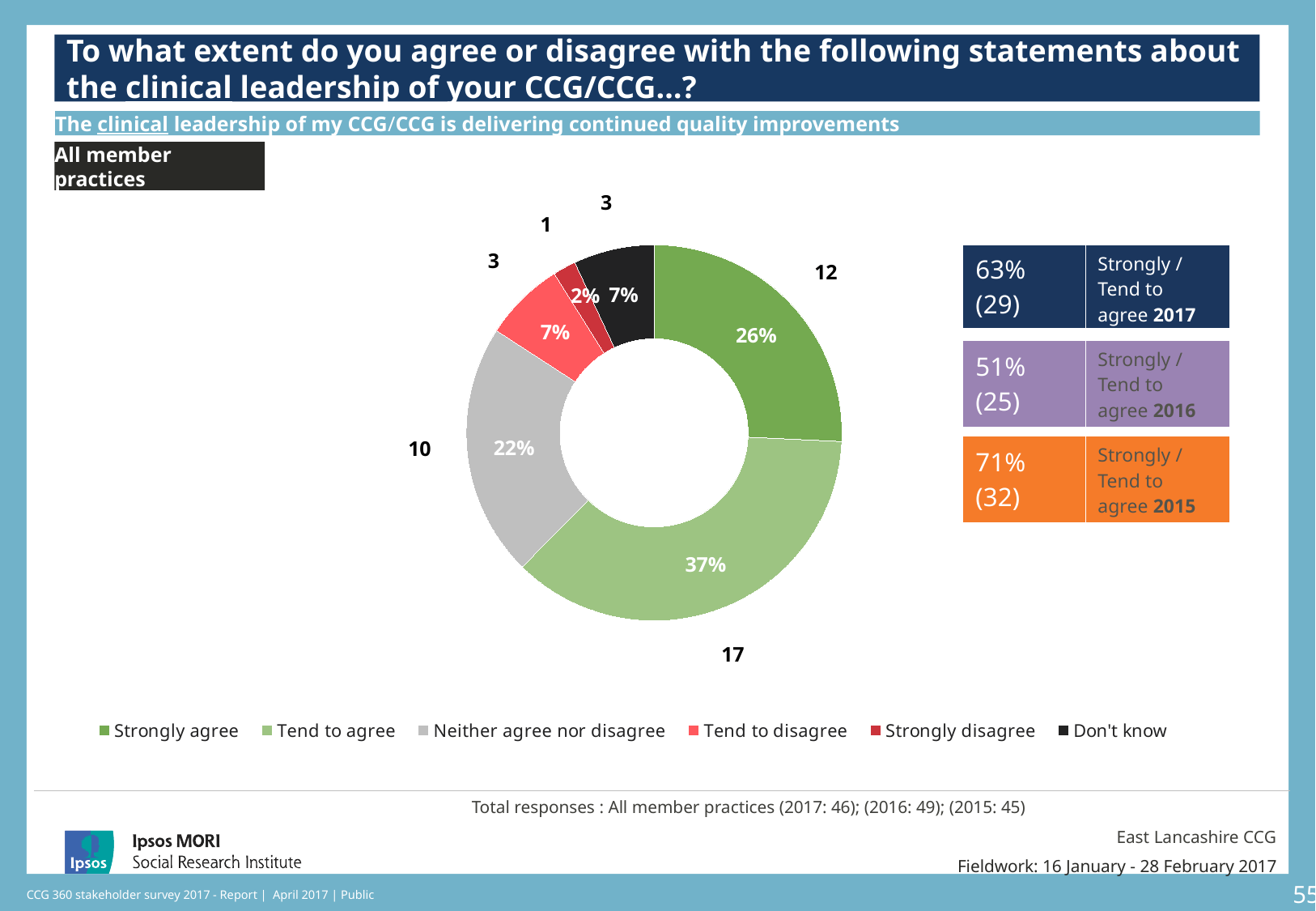
Which is larger: the share for 'Neither agree nor disagree' or the share for 'Tend to disagree'? Neither agree nor disagree What colour represents 'Don't know' in the chart? Black What percentage of respondents said they 'Tend to agree' that the clinical leadership of their CCG is delivering continued quality improvements? 37% What is the combined percentage of 'Strongly agree' and 'Tend to agree' responses? 63% What percentage of respondents answered 'Neither agree nor disagree'? 22% What is the difference in percentage points between 'Tend to agree' and 'Strongly agree'? 11 What percentage of respondents said they 'Strongly agree'? 26% Which response category has the smallest share of the donut chart? Strongly disagree Which response category has the largest share of the donut chart? Tend to agree What type of chart is used to show the responses? Donut (pie) chart How many response categories does the legend list? 6 How many respondents answered 'Strongly disagree'? 1